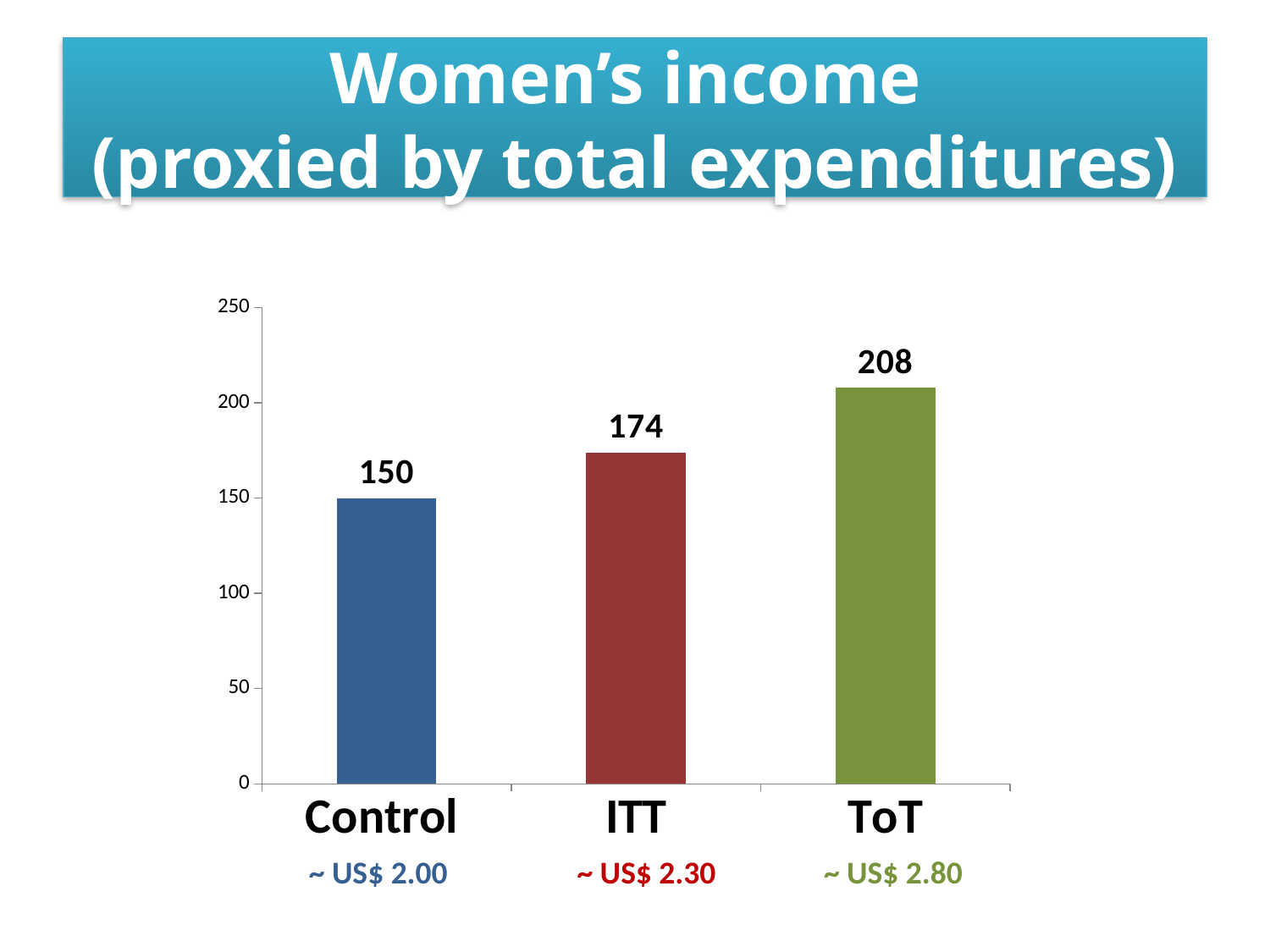
Is the value for ToT greater or less than 200? greater What kind of chart is shown on the slide? bar chart Which is larger, the value for ITT or the value for ToT? ToT What is the difference between the values for ITT and Control? 24 What is the value for Control? 150 What is the value for ITT? 174 Do the values rise or fall from Control to ToT along the x axis? rise Which category has the highest value? ToT What is the value for ToT? 208 Which category has the lowest value? Control How many categories are shown on the x axis? 3 What is the difference between the values for ToT and Control? 58